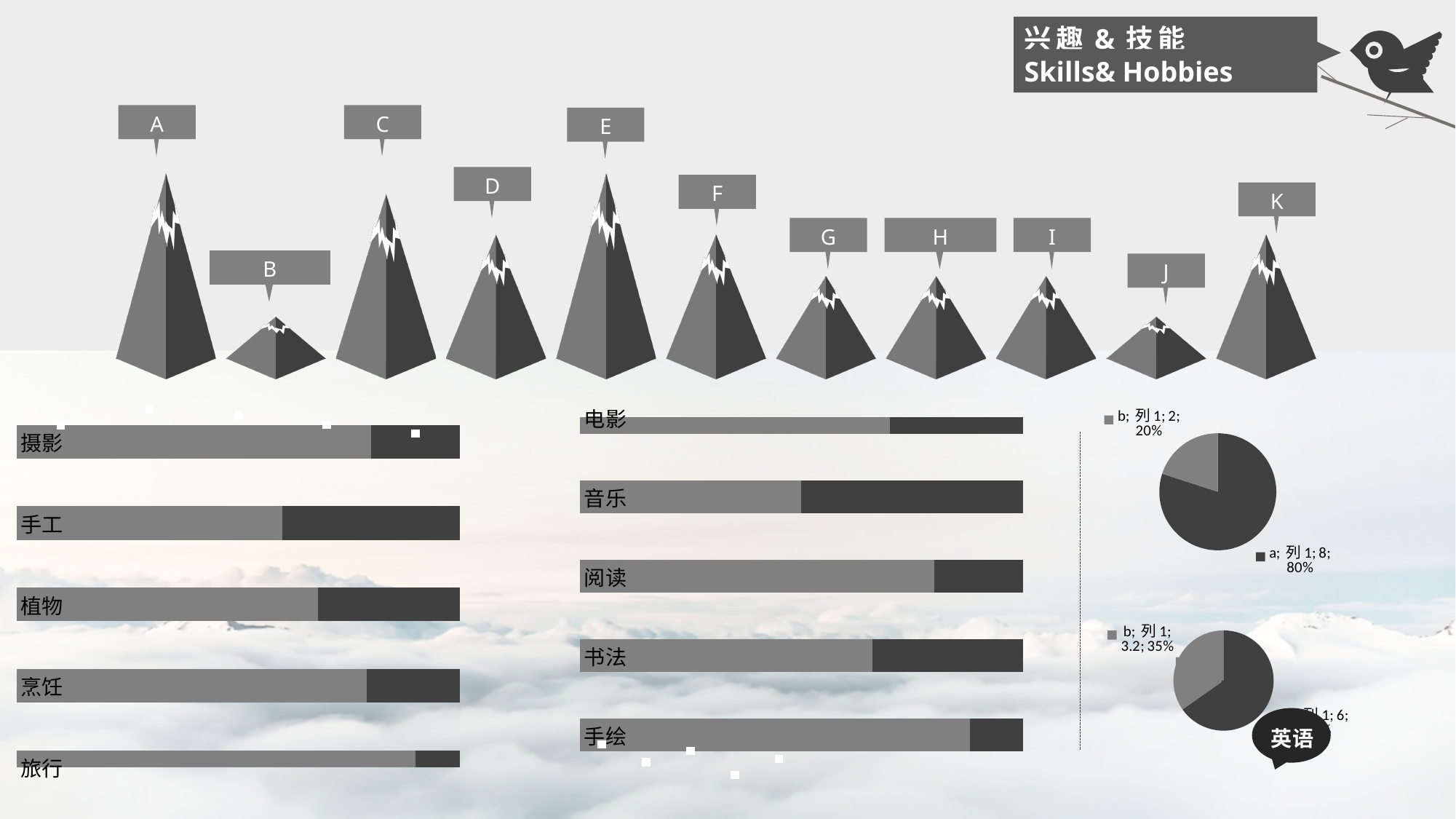
In the upper pie chart on the right, what share of the pie does slice a take? 80% How many slices does the upper pie chart on the right have? 2 In the lower pie chart on the right, what share of the pie does slice b take? 35% In the upper pie chart on the right, what is the value for slice b? 2 In the upper pie chart on the right, what share of the pie does slice b take? 20% What kind of chart is the upper chart on the right side of the slide? pie chart In the lower pie chart on the right, what is the value for slice b? 3.2 In the upper pie chart on the right, what is the difference between the values of slice a and slice b? 6 How many slices does the lower pie chart on the right have? 2 In the lower pie chart on the right, is the share for slice b greater or less than 50%? less In the upper pie chart on the right, what is the value for slice a? 8 In the upper pie chart on the right, which slice is larger, a or b? a